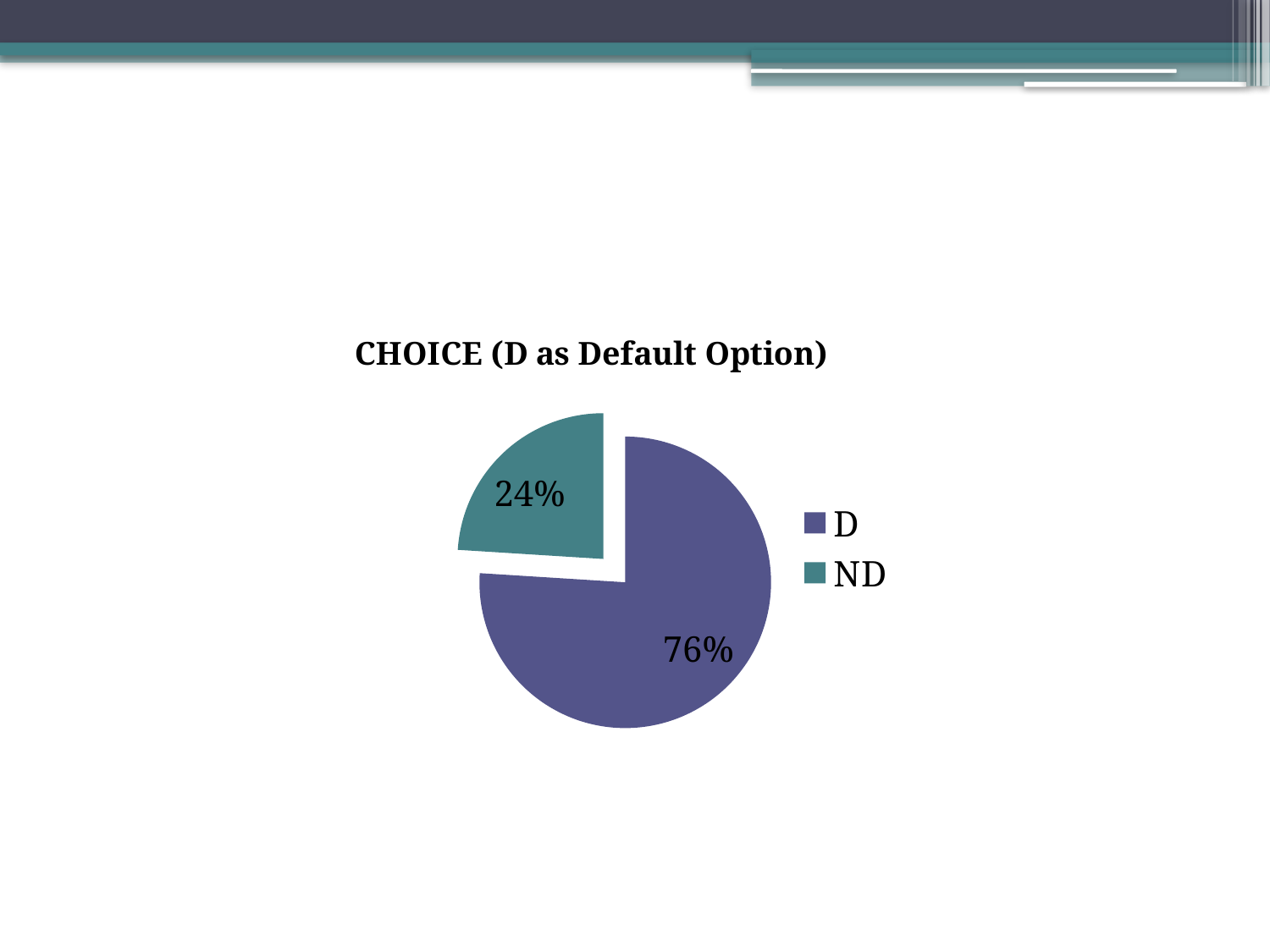
What share of the pie does D take? 76% How many entries does the legend list? 2 Which category has the smallest slice? ND Which category has the largest slice? D Which is larger, the slice for D or the slice for ND? D How many slices does the pie chart have? 2 What kind of chart is shown on the slide? pie chart Which category is shown in the teal colour? ND What share of the pie does ND take? 24% What is the title of the chart? CHOICE (D as Default Option) What is the difference in percentage points between the D slice and the ND slice? 52